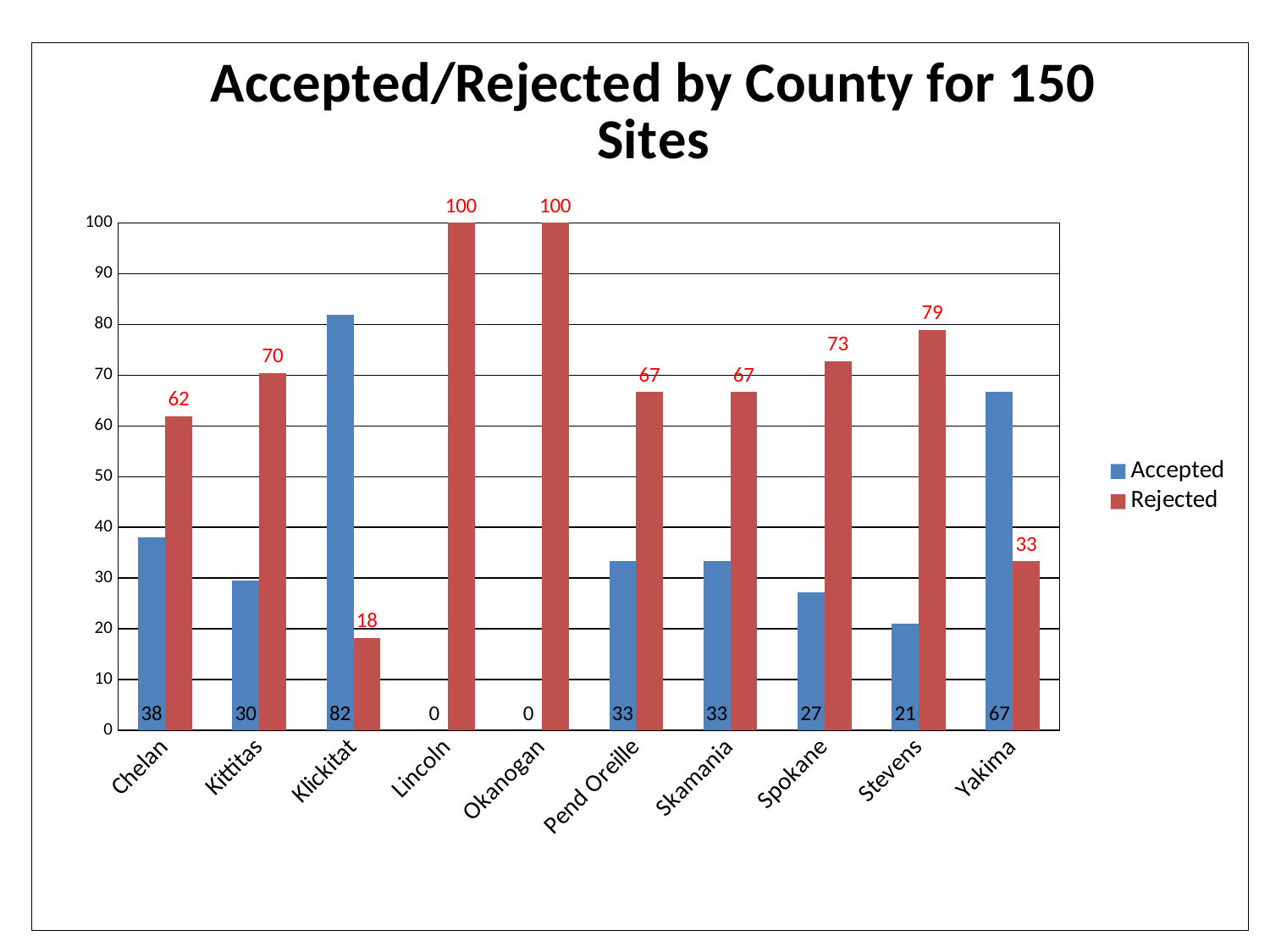
Which county has the lowest Rejected value? Klickitat What is the difference between the Rejected and Accepted values for Chelan? 24 What is the Accepted value for Klickitat? 82 Is the Rejected value for Kittitas greater or less than 60? greater What is the Accepted value for Spokane? 27 How many counties are shown on the x axis? 10 For Yakima, which is larger, the Accepted value or the Rejected value? Accepted What is the difference between the Rejected and Accepted values for Stevens? 58 What type of chart is shown on the slide? bar chart What is the Rejected value for Stevens? 79 How many series does the legend list? 2 Which county has the highest Accepted value? Klickitat